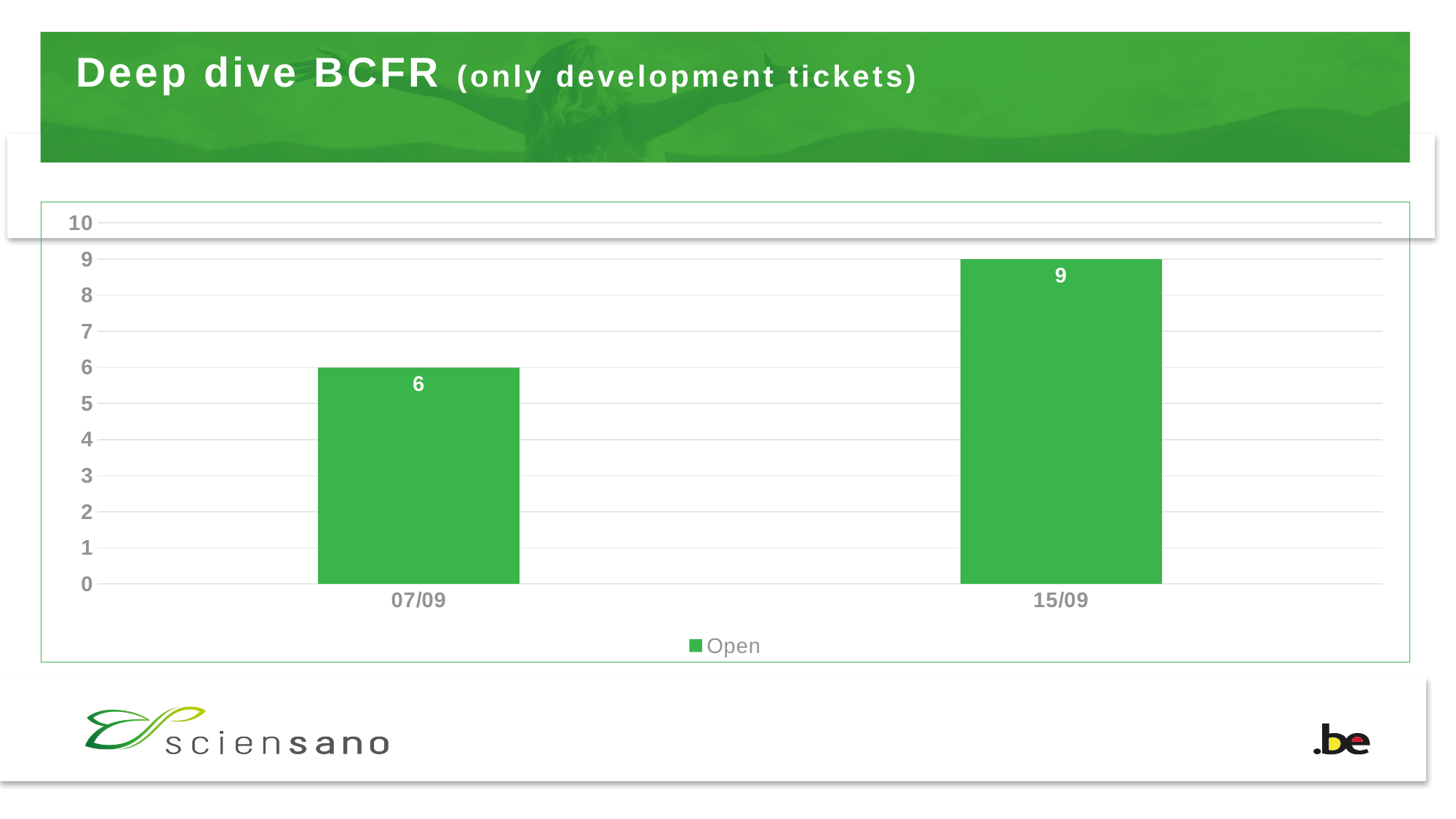
What is the name of the series in the legend? Open How many categories are shown on the x axis? 2 What is the difference between the values for 15/09 and 07/09? 3 Is the value for 15/09 greater or less than 8? greater What is the value for 15/09? 9 Which date has the highest value? 15/09 What is the value for 07/09? 6 How many series does the legend list? 1 Do the values rise or fall from 07/09 to 15/09? rise What kind of chart is shown on the slide? bar chart Which is larger, the value for 07/09 or the value for 15/09? 15/09 Which date has the lowest value? 07/09